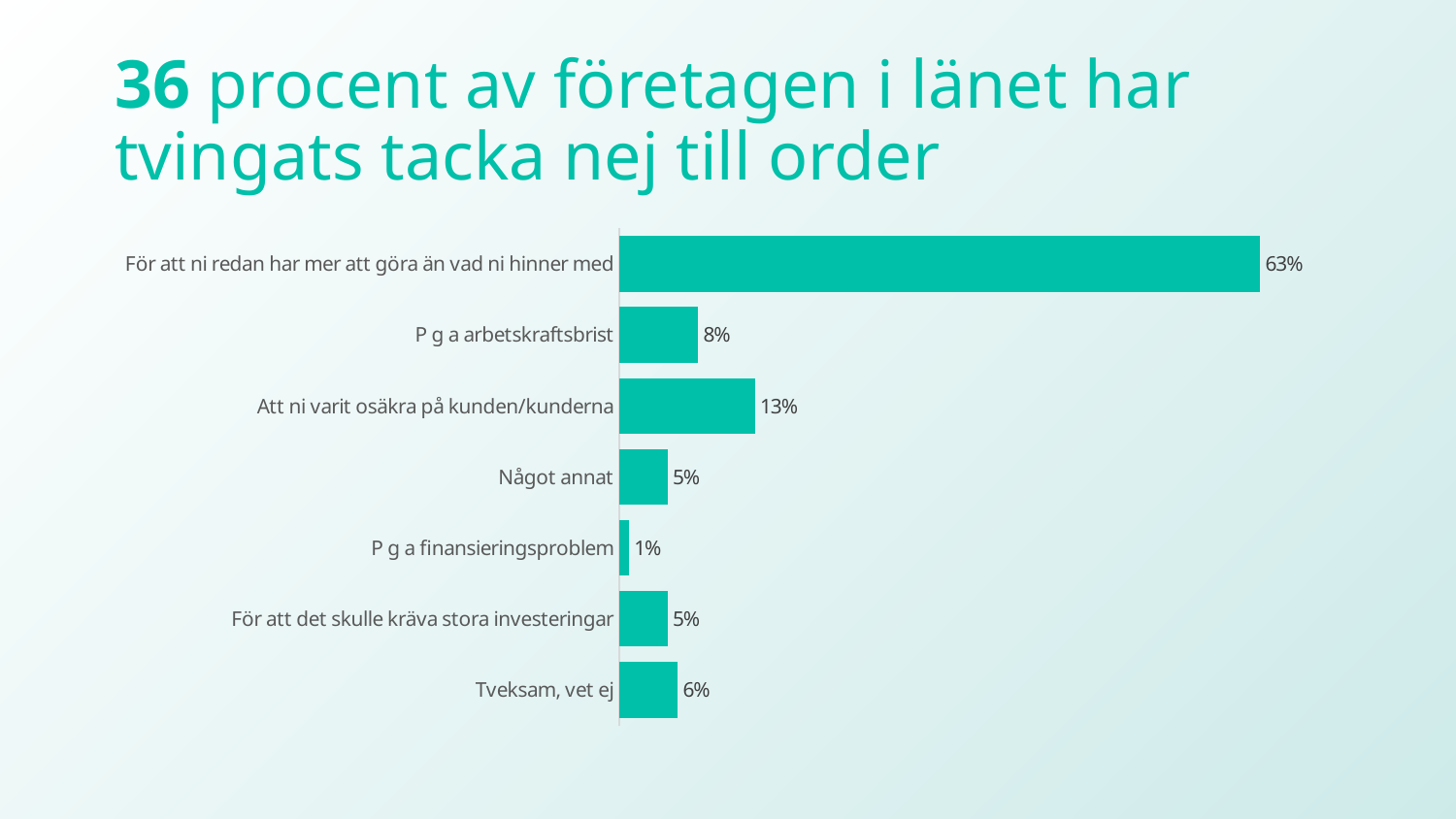
How many categories are shown in the chart? 7 What colour are the bars in the chart? Teal What is the value for "Tveksam, vet ej"? 6% Which is larger, the value for "Tveksam, vet ej" or the value for "Något annat"? Tveksam, vet ej What is the value for "P g a arbetskraftsbrist"? 8% Which category has the highest value? För att ni redan har mer att göra än vad ni hinner med What is the difference between the values for "Att ni varit osäkra på kunden/kunderna" and "P g a arbetskraftsbrist"? 5% What kind of chart is shown on the slide? Bar chart What is the difference between the values for "För att ni redan har mer att göra än vad ni hinner med" and "Att ni varit osäkra på kunden/kunderna"? 50% What is the value for "Att ni varit osäkra på kunden/kunderna"? 13% Which category has the lowest value? P g a finansieringsproblem What is the value for "För att ni redan har mer att göra än vad ni hinner med"? 63%